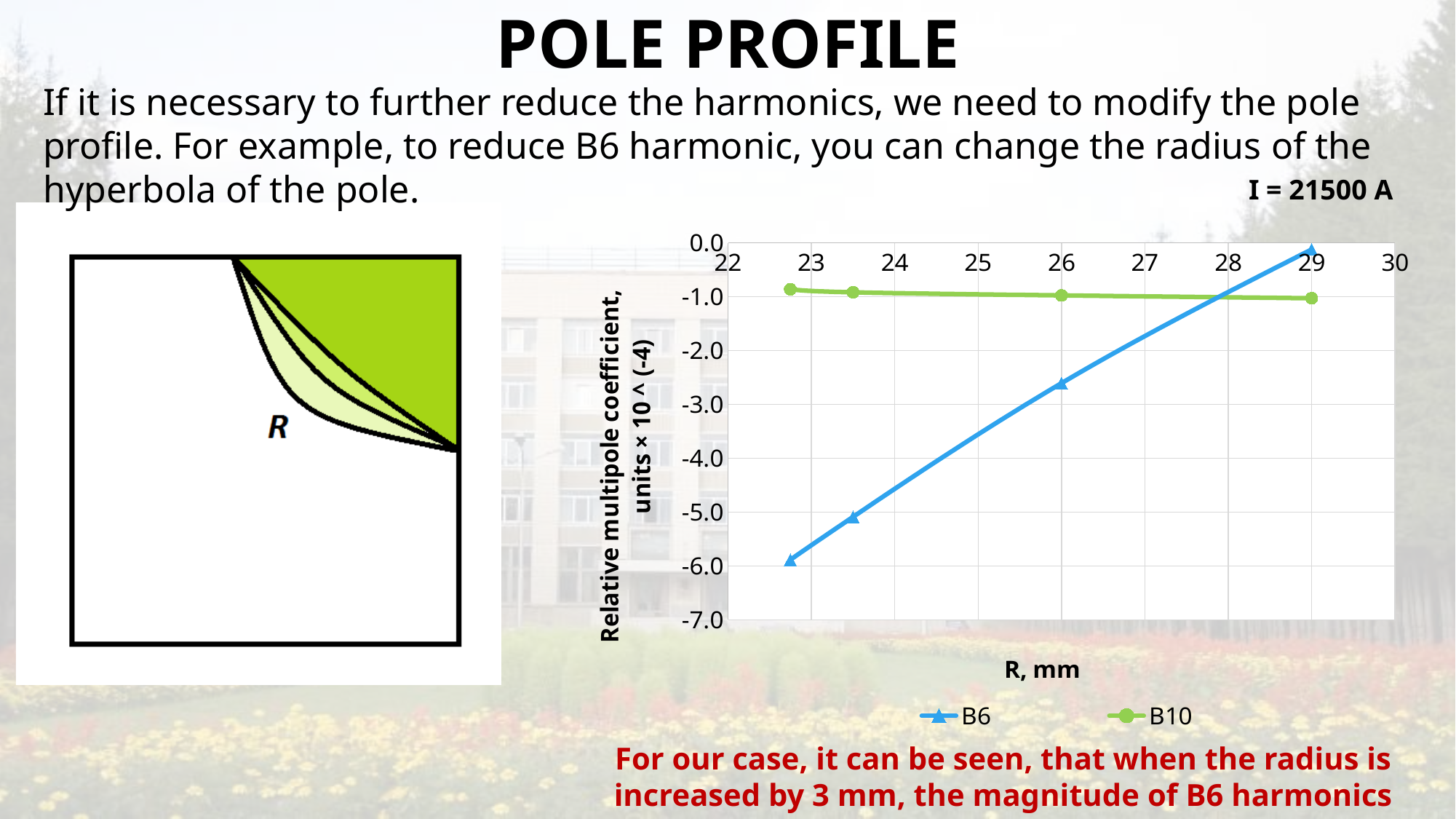
Which series has the lowest plotted value on the chart? B6 Is the leftmost B6 value (near R = 23 mm) greater or less than -5.0? less Does the B6 series rise or fall as R increases along the x axis? rise Does the B10 series rise or fall as R increases along the x axis? fall What kind of chart is shown on the slide? line chart How many data points are plotted for the B6 series? 4 How many series does the chart legend list? 2 Is the value of B6 at R = 26 mm greater or less than -3.0? greater Is the value of B6 at R = 26 mm greater or less than -2.0? less Which series are listed in the chart legend? B6 and B10 What is the x-axis title of the chart? R, mm At R = 26 mm, which series has the higher value, B6 or B10? B10